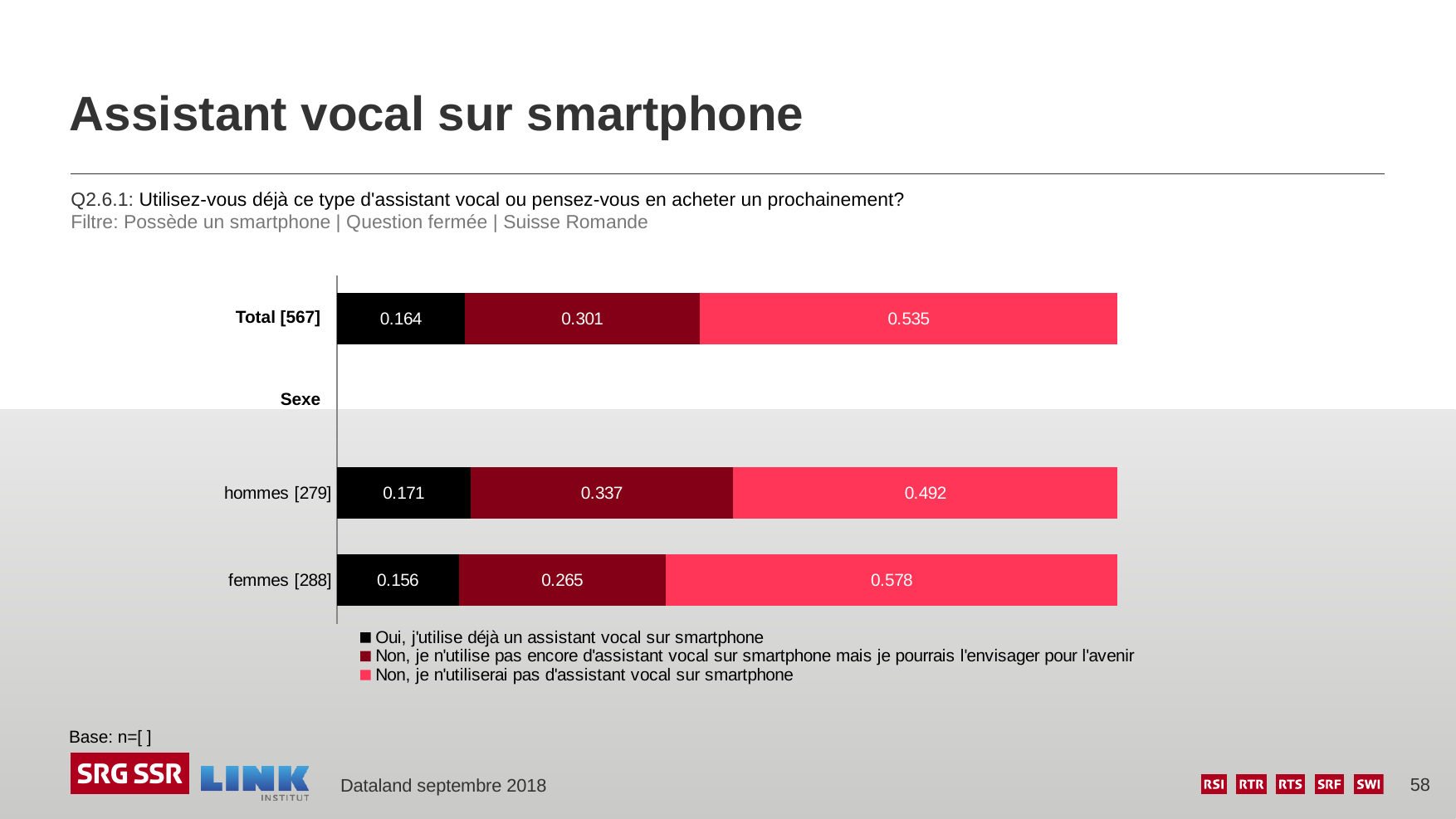
What kind of chart is shown on the slide? Stacked bar chart What is the value for "Oui, j'utilise déjà un assistant vocal sur smartphone" for Total [567]? 0.164 What is the value for "Non, je n'utiliserai pas d'assistant vocal sur smartphone" for hommes [279]? 0.492 What is the difference between hommes [279] and femmes [288] for "Non, je n'utilise pas encore d'assistant vocal sur smartphone mais je pourrais l'envisager pour l'avenir"? 0.072 Which category has the lowest value for "Oui, j'utilise déjà un assistant vocal sur smartphone"? femmes [288] Which category has the highest value for "Non, je n'utiliserai pas d'assistant vocal sur smartphone"? femmes [288] What is the total of the stacked bar for hommes [279]? 1.000 What is the value for "Non, je n'utilise pas encore d'assistant vocal sur smartphone mais je pourrais l'envisager pour l'avenir" for femmes [288]? 0.265 Which colour represents "Oui, j'utilise déjà un assistant vocal sur smartphone" in the legend? Black How many series does the legend list? 3 How many categories (bars) are shown in the chart? 3 Which is larger for "Non, je n'utiliserai pas d'assistant vocal sur smartphone": hommes [279] or femmes [288]? femmes [288]